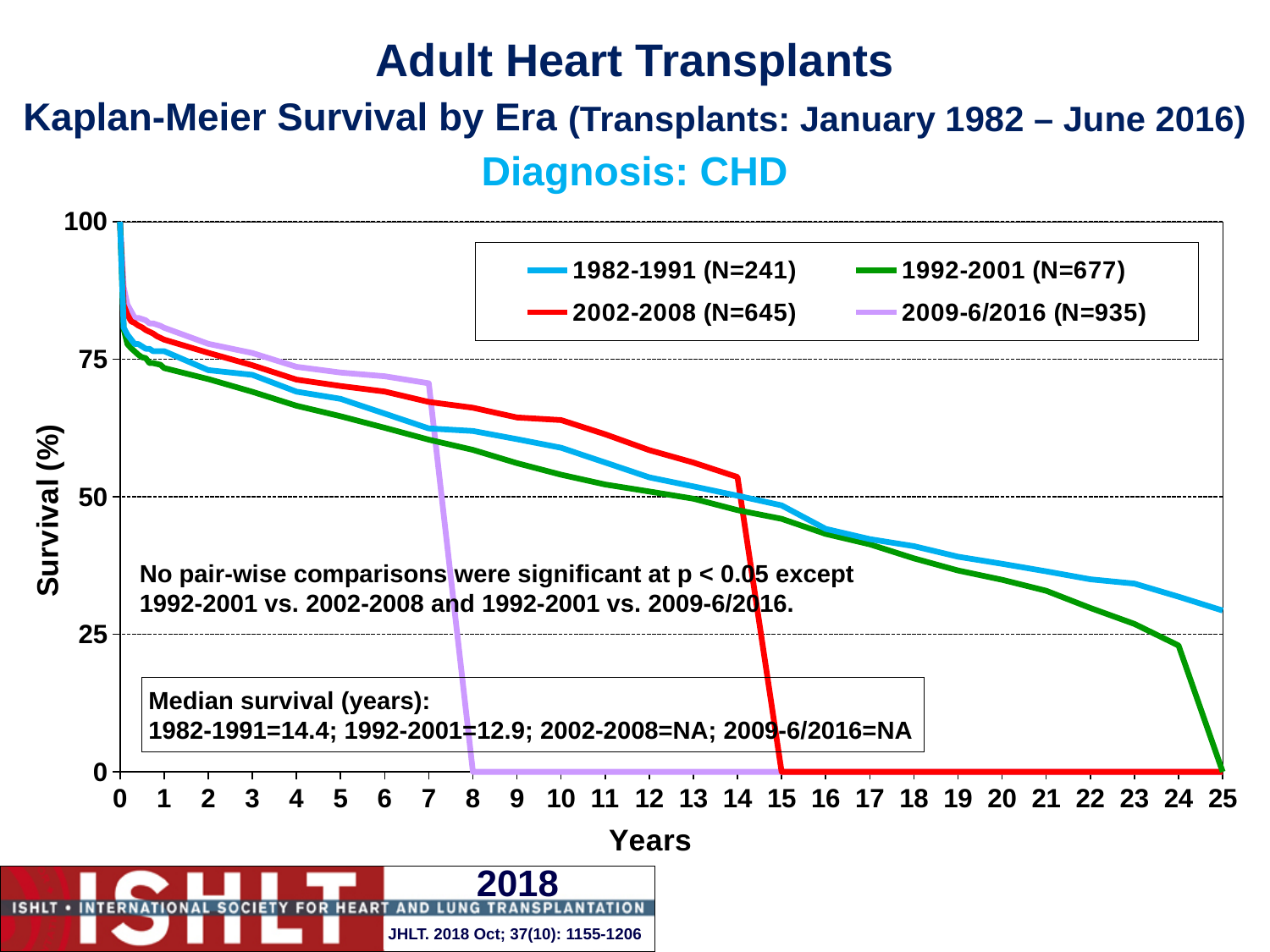
What is the median survival in years for the 1992-2001 era? 12.9 What is the difference in median survival years between the 1982-1991 and 1992-2001 eras? 1.5 How many transplants (N) are in the 2009-6/2016 era? 935 How many series does the legend list? 4 What kind of chart is shown on the slide? Line chart Is the survival for the 1992-2001 era at 20 years greater or less than 25? greater Which era has the smallest N in the legend? 1982-1991 (N=241) What diagnosis does the chart cover? CHD What is the median survival in years for the 1982-1991 era? 14.4 What is the median survival for the 2002-2008 era? NA At 12 years, which era has higher survival: 2002-2008 or 1992-2001? 2002-2008 Which era has the largest N in the legend? 2009-6/2016 (N=935)